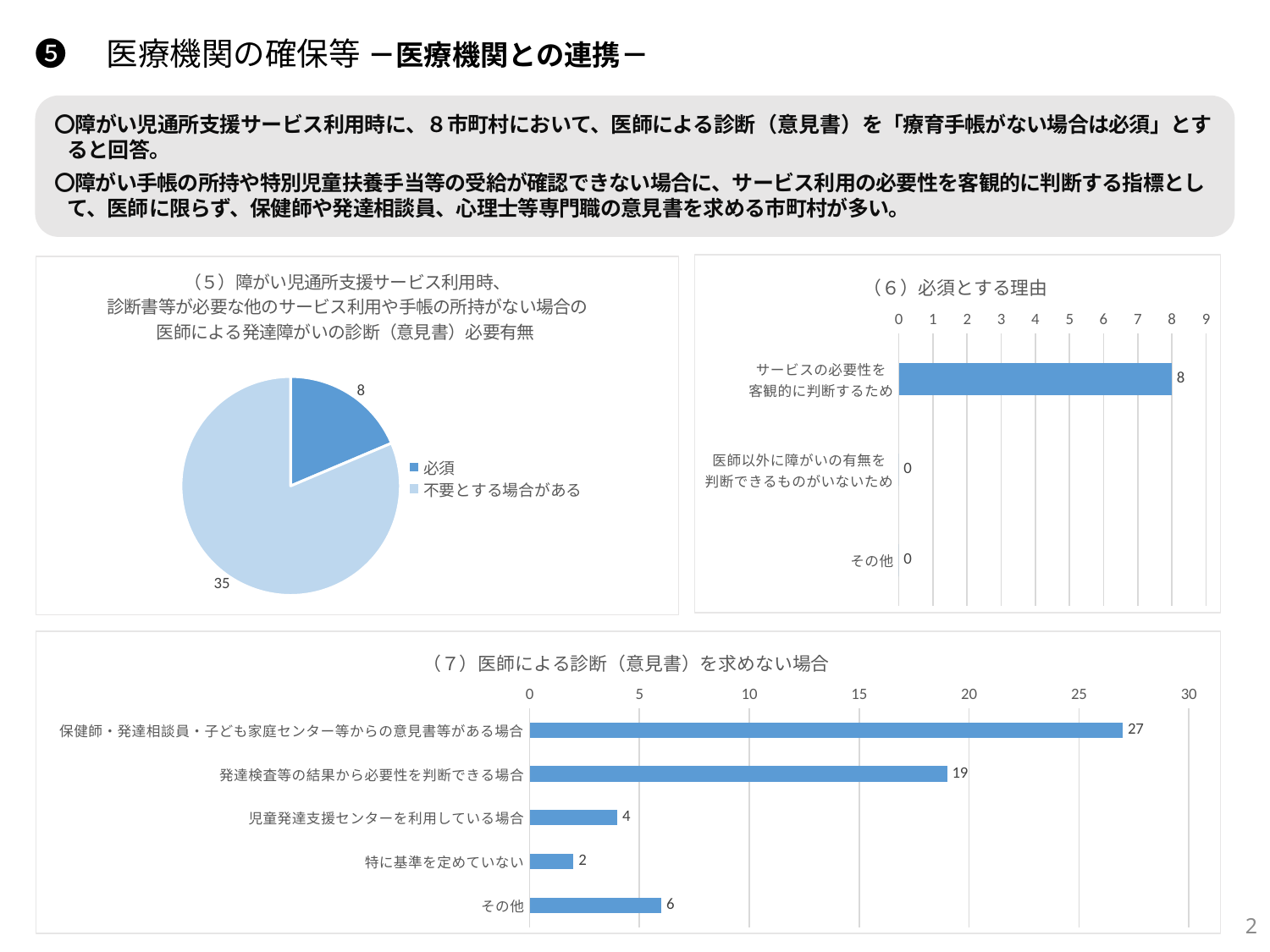
How many entries does the legend of the pie chart (5) list? 2 In the chart (6) 必須とする理由, what is the value for サービスの必要性を客観的に判断するため? 8 In the chart (7) 医師による診断（意見書）を求めない場合, what is the value for 発達検査等の結果から必要性を判断できる場合? 19 In the chart (7) 医師による診断（意見書）を求めない場合, which category has the lowest value? 特に基準を定めていない What kind of chart is chart (5) on the left of the slide? Pie chart In the pie chart (5) on the left, what value is shown for 必須? 8 In the chart (7) 医師による診断（意見書）を求めない場合, what is the difference between the values for 保健師・発達相談員・子ども家庭センター等からの意見書等がある場合 and 発達検査等の結果から必要性を判断できる場合? 8 In the chart (7) 医師による診断（意見書）を求めない場合, which category has the highest value? 保健師・発達相談員・子ども家庭センター等からの意見書等がある場合 In the chart (6) 必須とする理由, what is the value for その他? 0 In the pie chart (5) on the left, what value is shown for 不要とする場合がある? 35 In the pie chart (5) on the left, what is the difference between the values for 不要とする場合がある and 必須? 27 How many categories are shown in the chart (6) 必須とする理由? 3